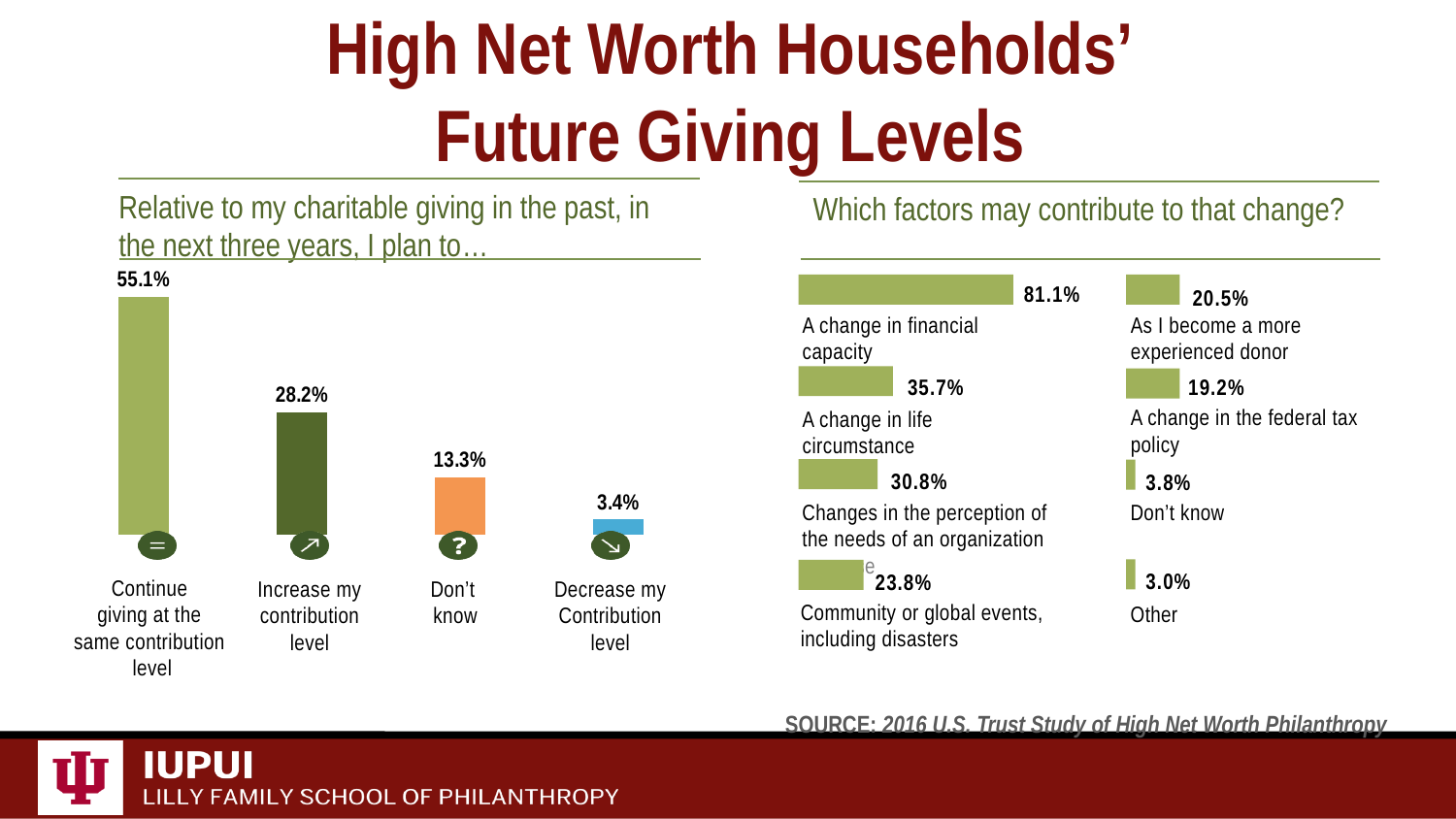
In the right chart ('Which factors may contribute to that change?'), what percentage cited a change in the federal tax policy? 19.2% In the left chart ('Relative to my charitable giving in the past, in the next three years, I plan to…'), what percentage plan to continue giving at the same contribution level? 55.1% In the right chart ('Which factors may contribute to that change?'), which factor has the lowest value? Other In the left chart ('Relative to my charitable giving in the past, in the next three years, I plan to…'), how many categories are shown? 4 In the left chart ('Relative to my charitable giving in the past, in the next three years, I plan to…'), which category has the highest value? Continue giving at the same contribution level In the left chart ('Relative to my charitable giving in the past, in the next three years, I plan to…'), what is the difference between 'Increase my contribution level' and 'Don't know'? 14.9% In the left chart ('Relative to my charitable giving in the past, in the next three years, I plan to…'), what percentage plan to decrease their contribution level? 3.4% In the right chart ('Which factors may contribute to that change?'), what percentage cited a change in financial capacity? 81.1% In the right chart ('Which factors may contribute to that change?'), what is the difference between 'A change in financial capacity' and 'A change in life circumstance'? 45.4% In the right chart ('Which factors may contribute to that change?'), how many factors are listed? 8 What type of chart is the left chart ('Relative to my charitable giving in the past, in the next three years, I plan to…')? Bar chart In the right chart ('Which factors may contribute to that change?'), which is larger: 'A change in life circumstance' or 'Changes in the perception of the needs of an organization'? A change in life circumstance